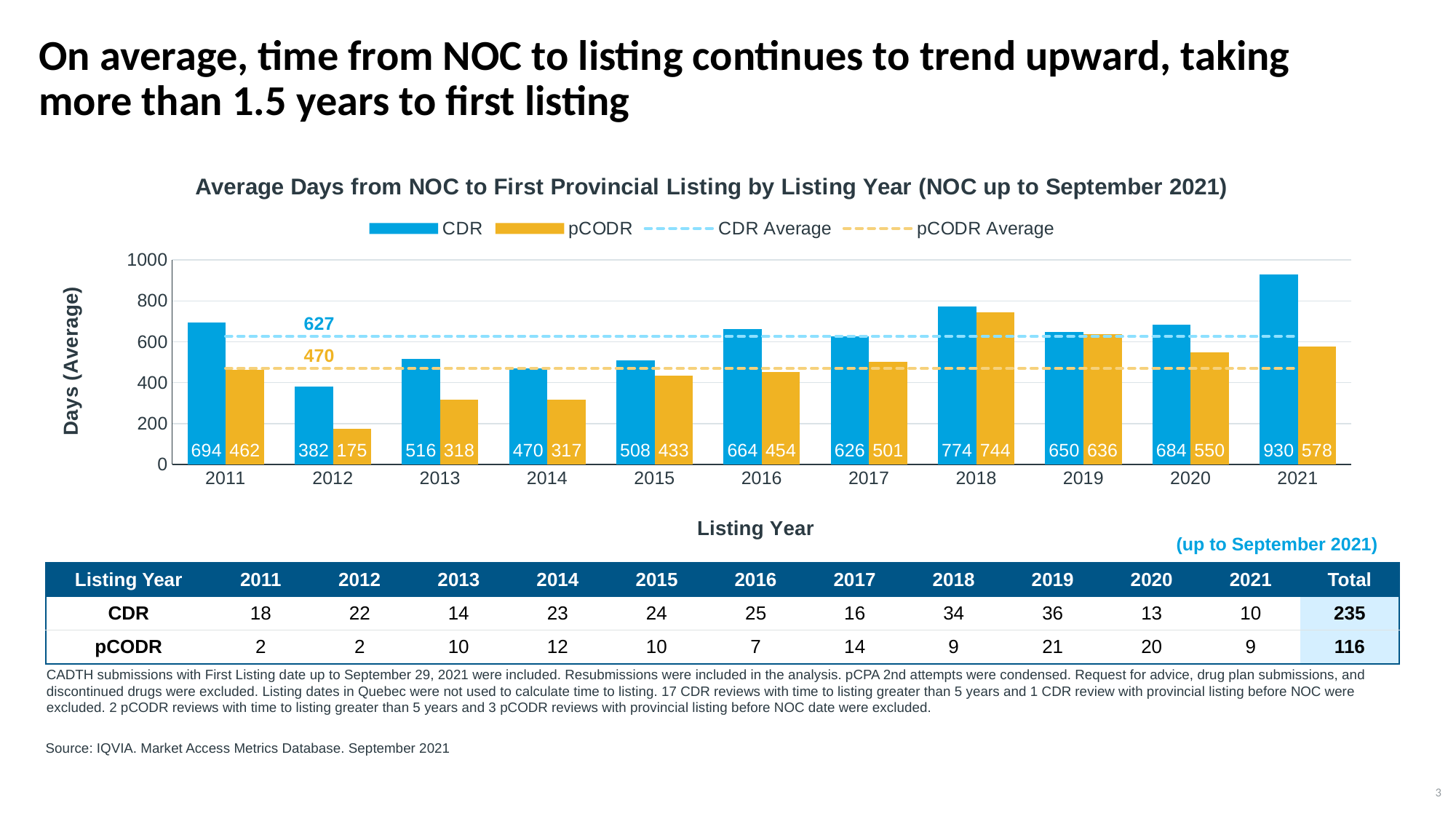
Which is larger in 2014, the CDR value or the pCODR value? CDR Which year has the highest CDR value? 2021 What is the value of the CDR Average line? 627 How many entries does the legend list? 4 What is the difference between the CDR and pCODR values in 2021? 352 What kind of chart is this? bar chart How many listing years are shown on the x axis? 11 What is the label of the y axis? Days (Average) What is the CDR value for 2018? 774 What is the pCODR value for 2012? 175 Is the CDR value for 2021 greater or less than 800? greater Which year has the lowest pCODR value? 2012